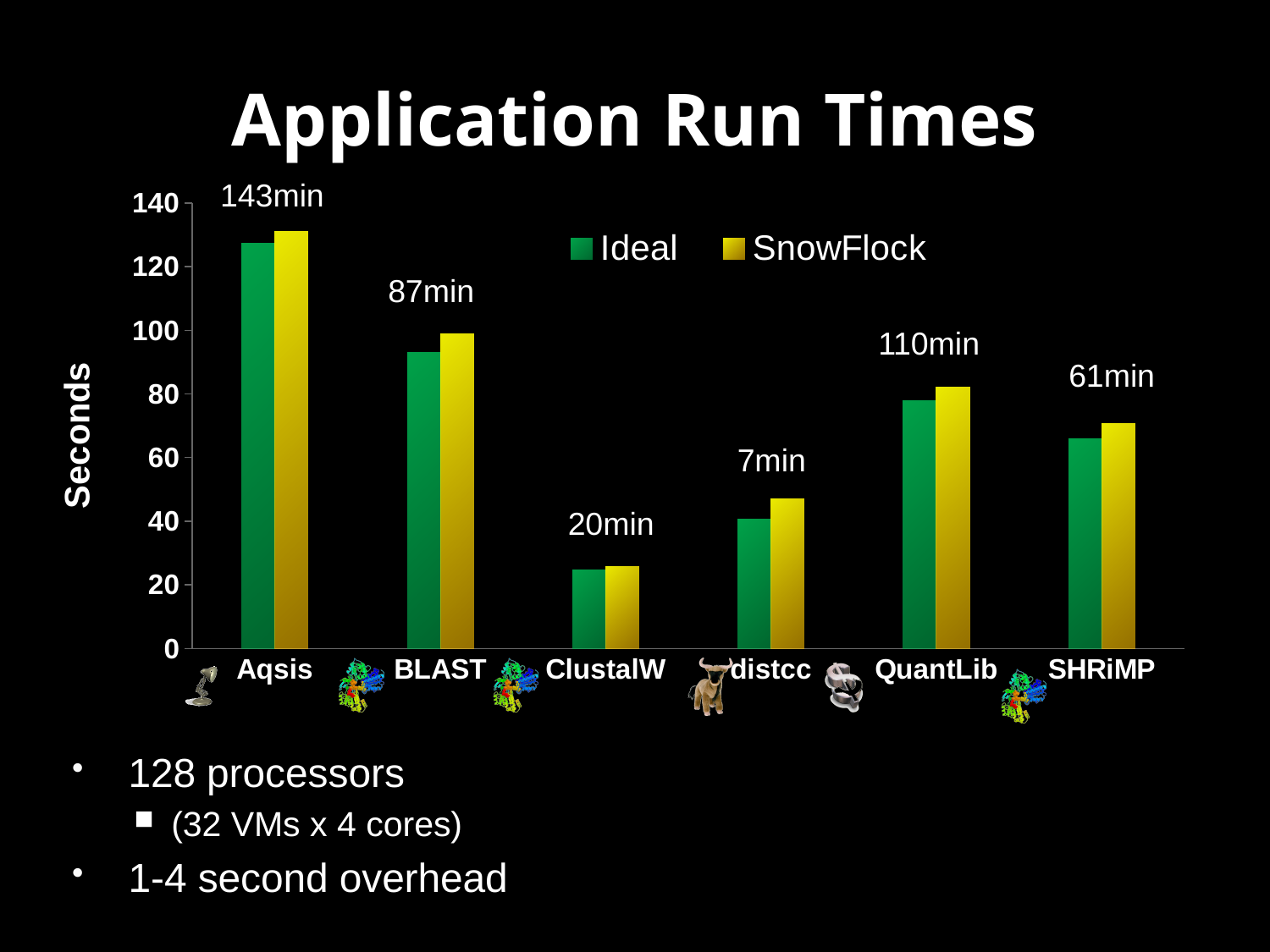
How many applications (categories) are shown on the x axis? 6 Which is larger, the SnowFlock value for QuantLib or the SnowFlock value for SHRiMP? QuantLib Is the Ideal value for ClustalW greater or less than 40? less Is the Ideal value for BLAST greater or less than 100? less What is the label on the vertical axis? Seconds What annotation is printed above the Aqsis bars? 143min Is the SnowFlock value for Aqsis greater or less than 120? greater Which application has the lowest SnowFlock run time? ClustalW Which application has the highest Ideal run time? Aqsis What kind of chart is shown on the slide? bar chart How many series does the legend list? 2